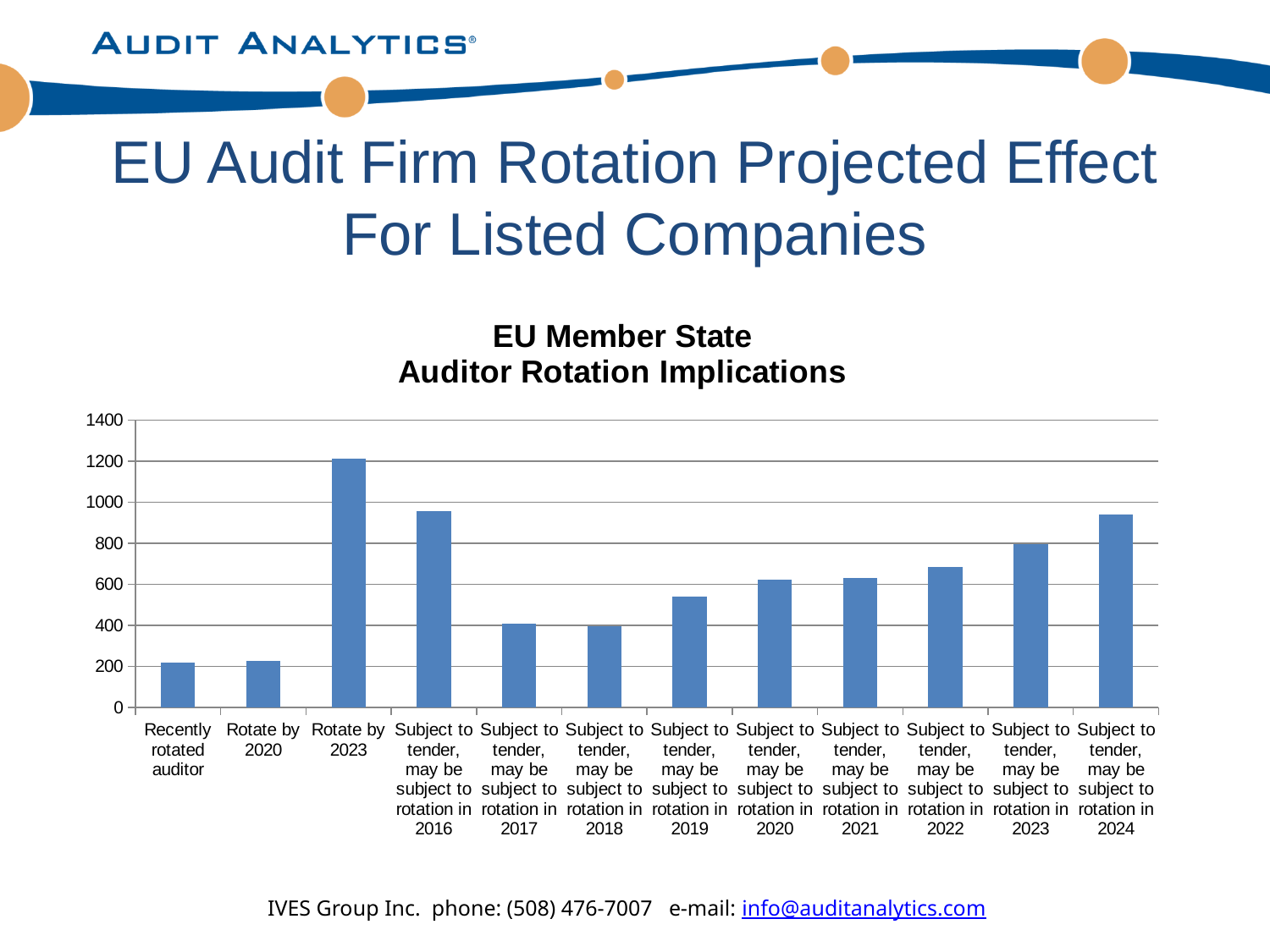
Is the value for 'Recently rotated auditor' greater or less than 400? less Which category has the highest value? Rotate by 2023 From the 2018 category through the 2024 category, do the bar values generally rise or fall? rise Is the value for 'Rotate by 2023' greater or less than 1000? greater Is the value for 'Subject to tender, may be subject to rotation in 2017' greater or less than 600? less What kind of chart is shown on the slide? Bar chart How many categories (bars) are plotted in the chart? 12 Which is larger: the value for 'Rotate by 2023' or the value for 'Subject to tender, may be subject to rotation in 2016'? Rotate by 2023 What is the title of the chart? EU Member State Auditor Rotation Implications Which is larger: the value for 'Subject to tender, may be subject to rotation in 2019' or for 'Subject to tender, may be subject to rotation in 2017'? Subject to tender, may be subject to rotation in 2019